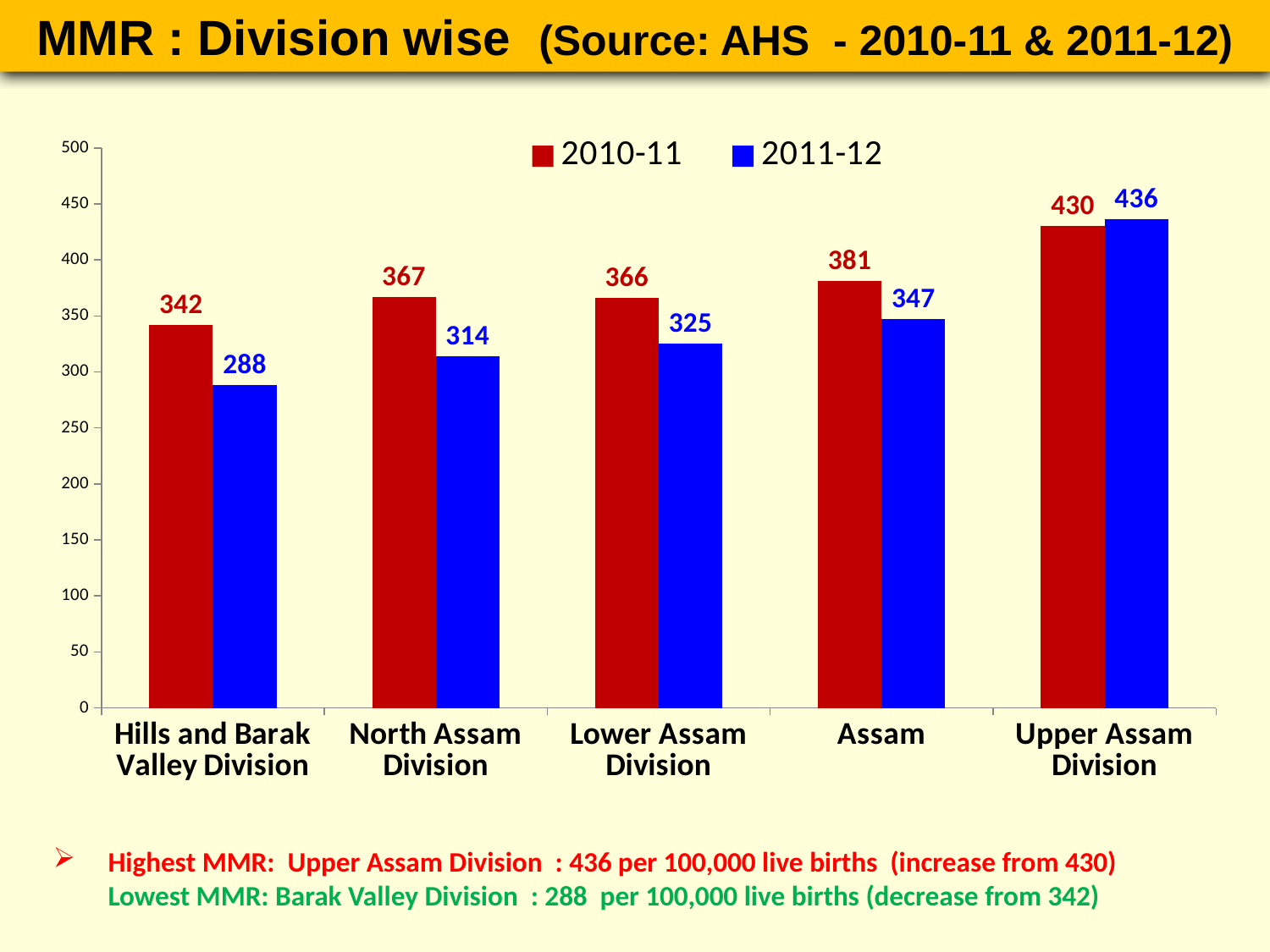
How many series does the legend list? 2 Which colour represents the 2011-12 series? blue What is the difference between the 2010-11 and 2011-12 values for Lower Assam Division? 41 What is the 2011-12 MMR value for Assam? 347 How many categories are shown on the x axis? 5 What is the 2011-12 MMR value for North Assam Division? 314 Which is larger for Upper Assam Division, the 2010-11 value or the 2011-12 value? 2011-12 Which category has the highest 2011-12 value? Upper Assam Division Is the 2010-11 value for Assam greater or less than 350? greater What is the 2010-11 MMR value for Hills and Barak Valley Division? 342 Which category has the lowest 2011-12 value? Hills and Barak Valley Division What kind of chart is shown on the slide? bar chart